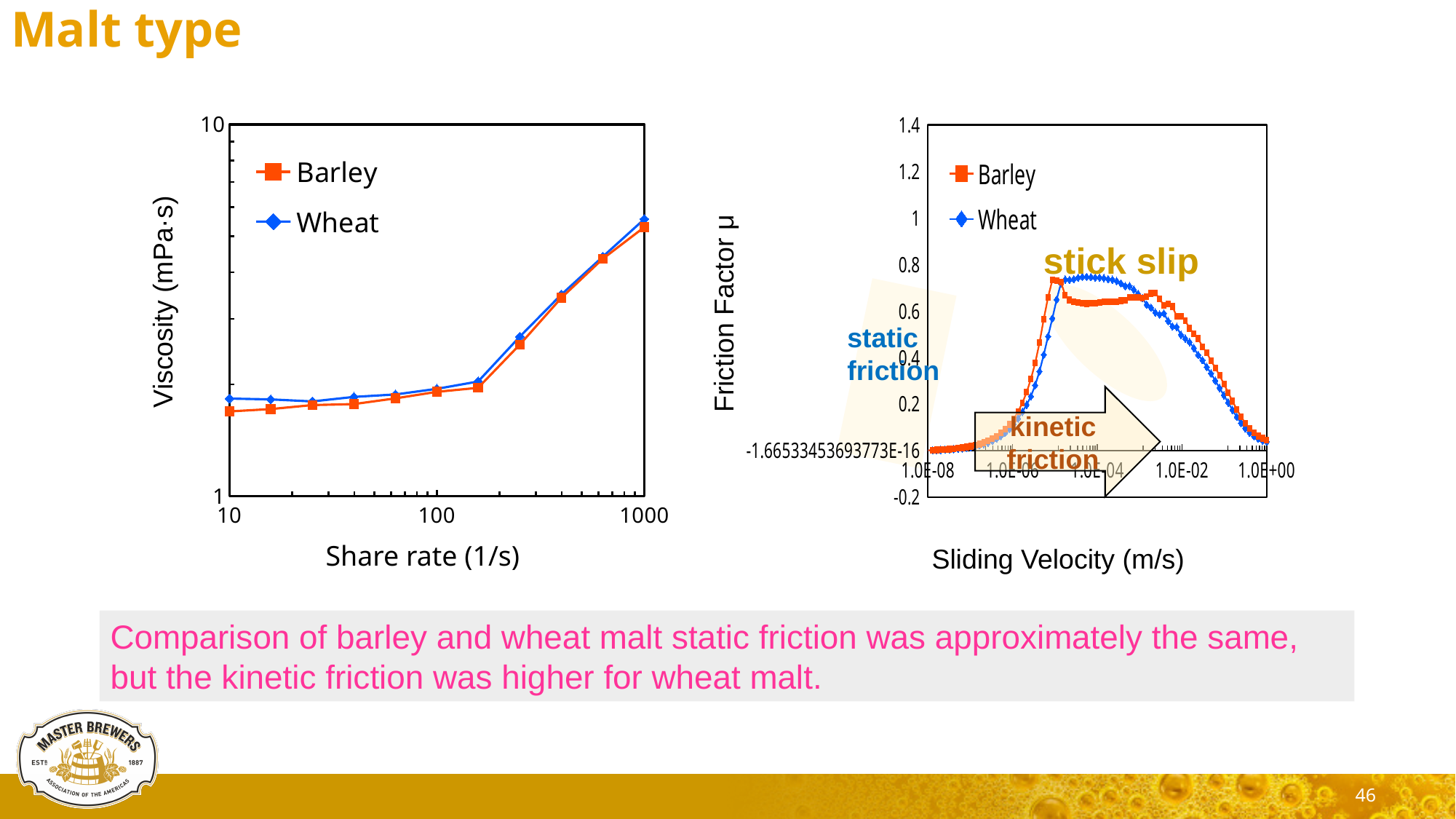
What kind of chart is the right chart (Friction Factor vs Sliding Velocity)? line chart How many series does the legend of the left chart list? 2 In the left chart, is the viscosity for Wheat at a share rate of 10 greater or less than 10? less What kind of chart is the left chart (Viscosity vs Share rate)? line chart What are the two series named in the legend of the right chart? Barley and Wheat In the right chart, is the friction factor for Barley at a sliding velocity of 1.0E-08 greater or less than 0.2? less In the right chart, which series has the higher friction factor at a sliding velocity of 1.0E-04, Barley or Wheat? Wheat In the left chart, does viscosity rise or fall as share rate increases from 10 to 1000? rise In the right chart, is the peak friction factor for Wheat greater or less than 0.6? greater What is the x-axis title of the left chart? Share rate (1/s) In the right chart, does the friction factor rise or fall as sliding velocity increases from 1.0E-02 to 1.0E+00? fall